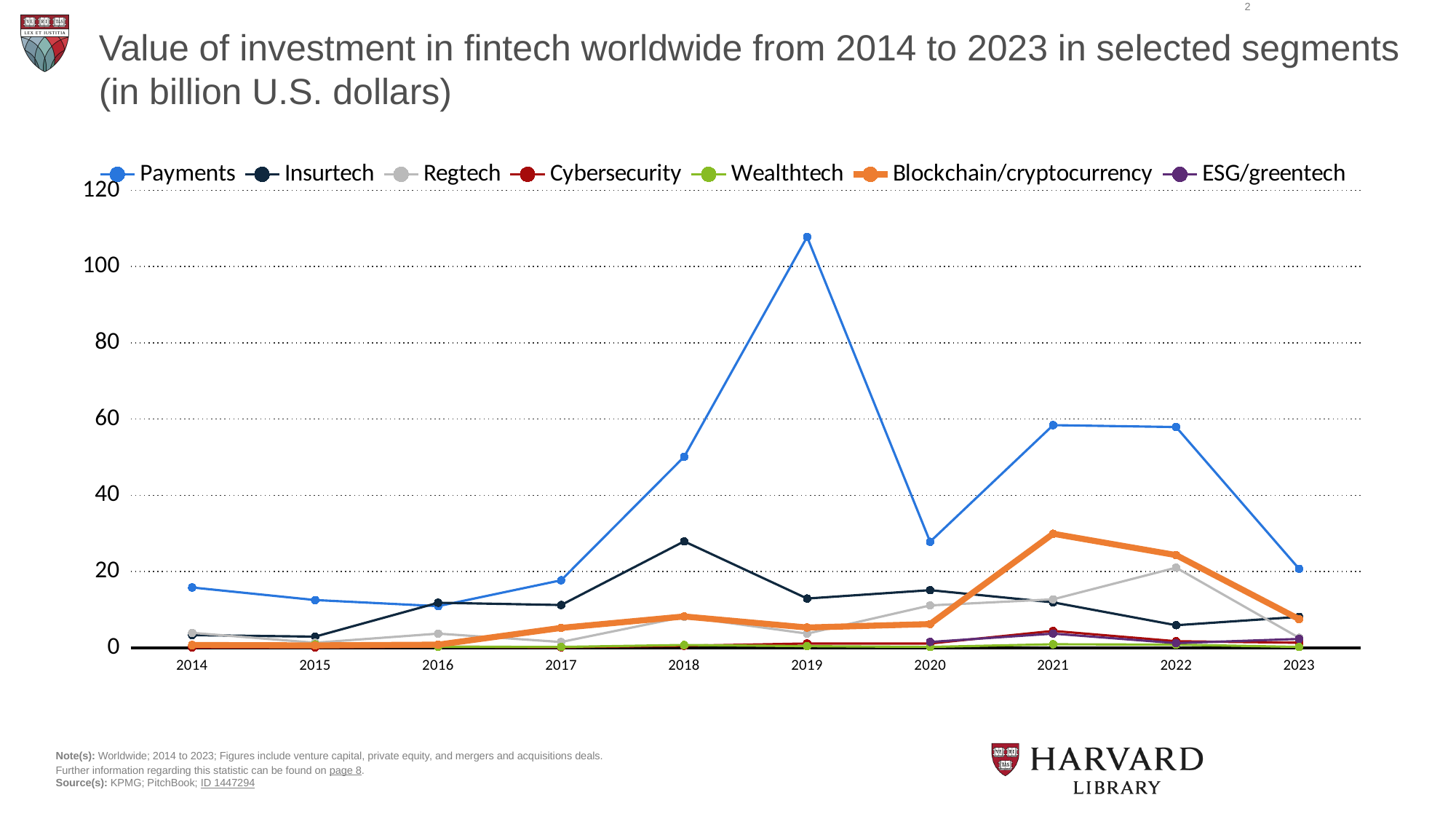
How many years are plotted along the x axis? 10 In 2022, which is larger: Regtech or Insurtech? Regtech What kind of chart is shown on the slide? line chart Is the value for Payments in 2023 greater or less than 40? less Is the value for Payments in 2019 greater or less than 100? greater Does the Payments series rise or fall from 2019 to 2020? fall How many series does the legend list? 7 What unit does the chart title say the values are in? billion U.S. dollars Is the value for Insurtech in 2018 greater or less than 20? greater In 2021, which is larger: Payments or Blockchain/cryptocurrency? Payments In which year does the Blockchain/cryptocurrency series reach its highest value? 2021 In which year does the Payments series reach its highest value? 2019